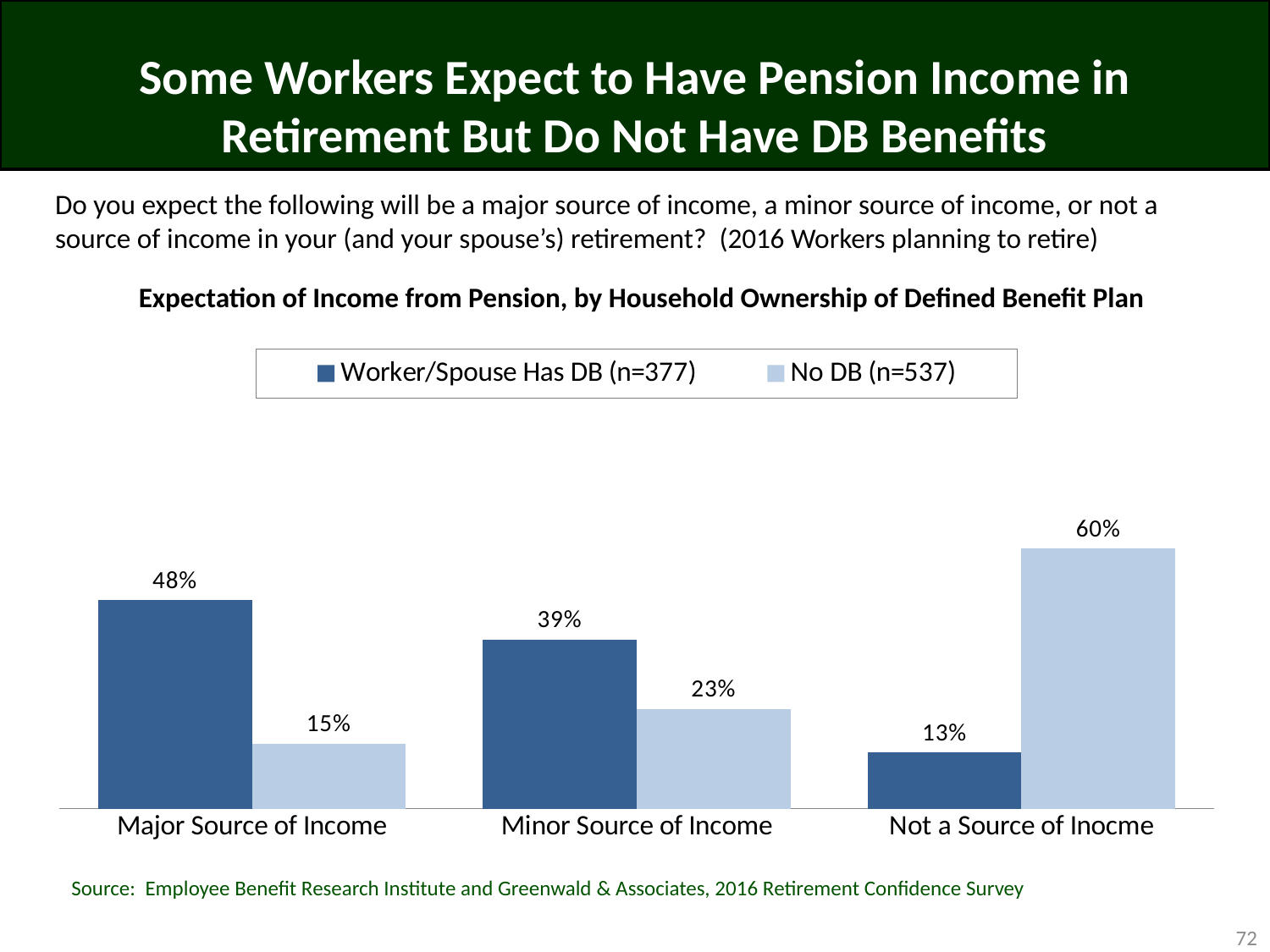
How many categories are shown on the x axis? 3 What is the difference between the No DB and Worker/Spouse Has DB values for Not a Source of Income? 47 percentage points For Minor Source of Income, which series has the larger value? Worker/Spouse Has DB What is the sample size (n) for the No DB series shown in the legend? 537 What kind of chart is shown on the slide? Bar chart How many series does the legend list? 2 What is the value for No DB in the Not a Source of Income category? 60% What is the difference between the Worker/Spouse Has DB and No DB values for Major Source of Income? 33 percentage points Which category has the lowest value for the Worker/Spouse Has DB series? Not a Source of Income What percentage of workers whose household has a DB plan expect pension to be a major source of income? 48% What is the value for Worker/Spouse Has DB in the Minor Source of Income category? 39% Which category has the highest value for the No DB series? Not a Source of Income